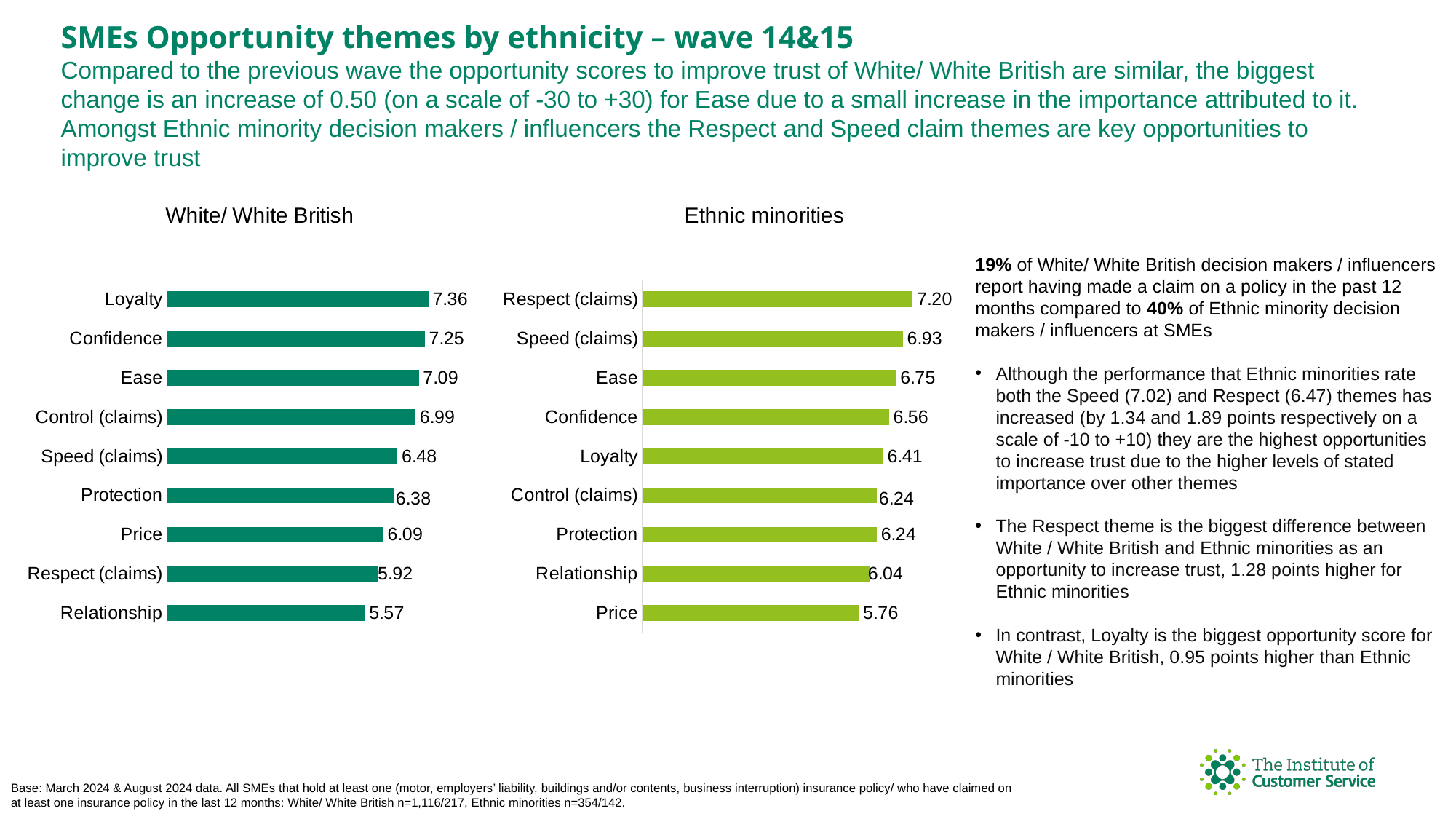
In the White/ White British chart, what is the value for Respect (claims)? 5.92 In the Ethnic minorities chart, what is the value for Speed (claims)? 6.93 In the White/ White British chart, which category has the lowest value? Relationship In the White/ White British chart, what is the value for Loyalty? 7.36 How many categories are shown in the Ethnic minorities chart? 9 In the Ethnic minorities chart, which category has the highest value? Respect (claims) In the White/ White British chart, what is the difference between Loyalty and Relationship? 1.79 In the Ethnic minorities chart, which category has the lowest value? Price What kind of chart is the White/ White British chart? Bar chart In the White/ White British chart, which is larger: Price or Protection? Protection Which is larger: Ease in the White/ White British chart or Ease in the Ethnic minorities chart? White/ White British In the Ethnic minorities chart, what is the difference between Respect (claims) and Price? 1.44